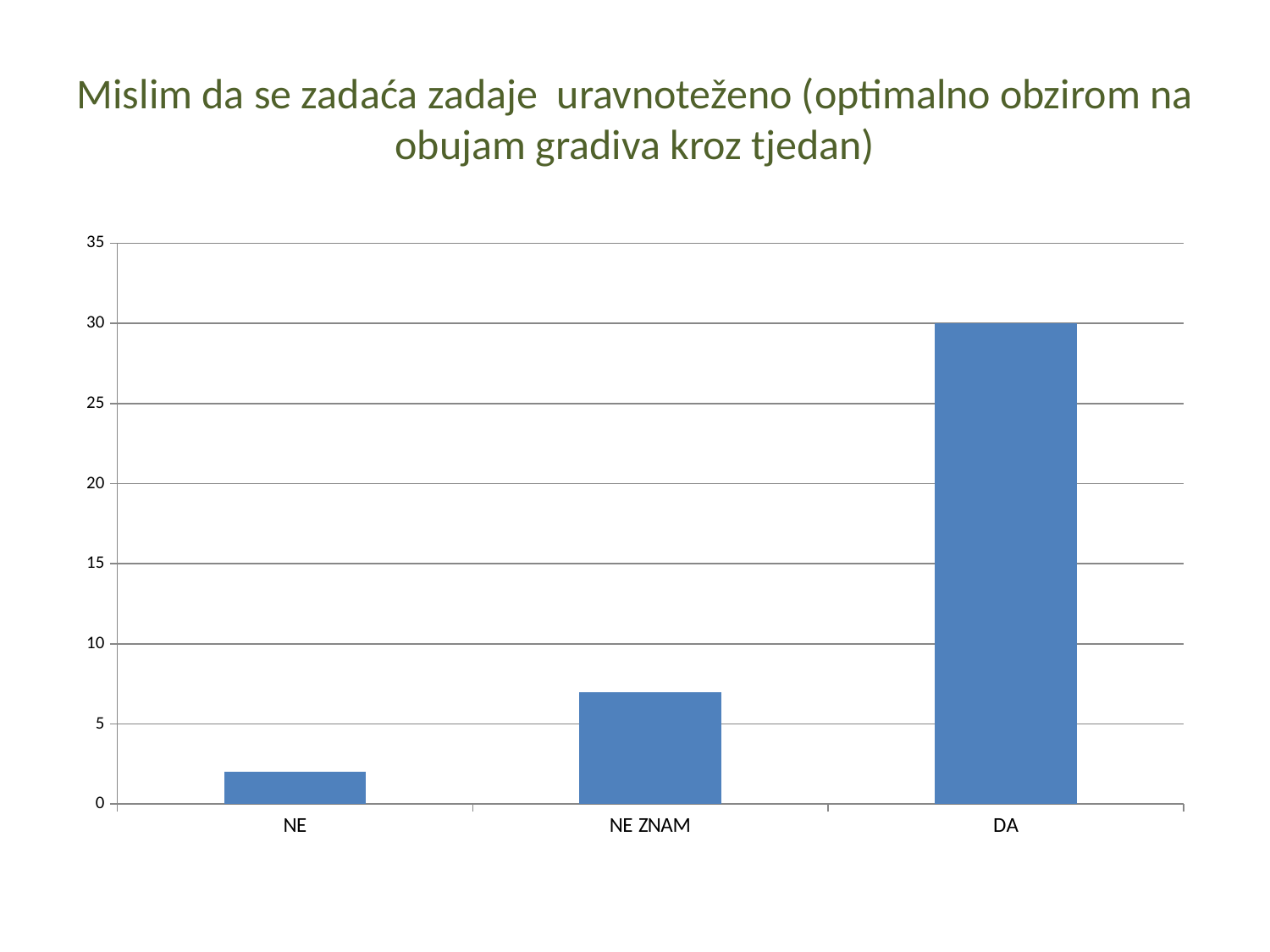
Is the value for NE greater or less than 5? less What is the highest value shown on the vertical axis? 35 What is the value for DA? 30 How many categories are shown on the x axis of the chart? 3 Which category has the highest bar? DA What kind of chart is shown on the slide? bar chart Which is larger, the value for NE ZNAM or the value for NE? NE ZNAM Is the value for NE ZNAM greater or less than 5? greater Which category has the lowest bar? NE Is the value for DA greater or less than 25? greater Do the values rise or fall from left to right along the x axis? rise